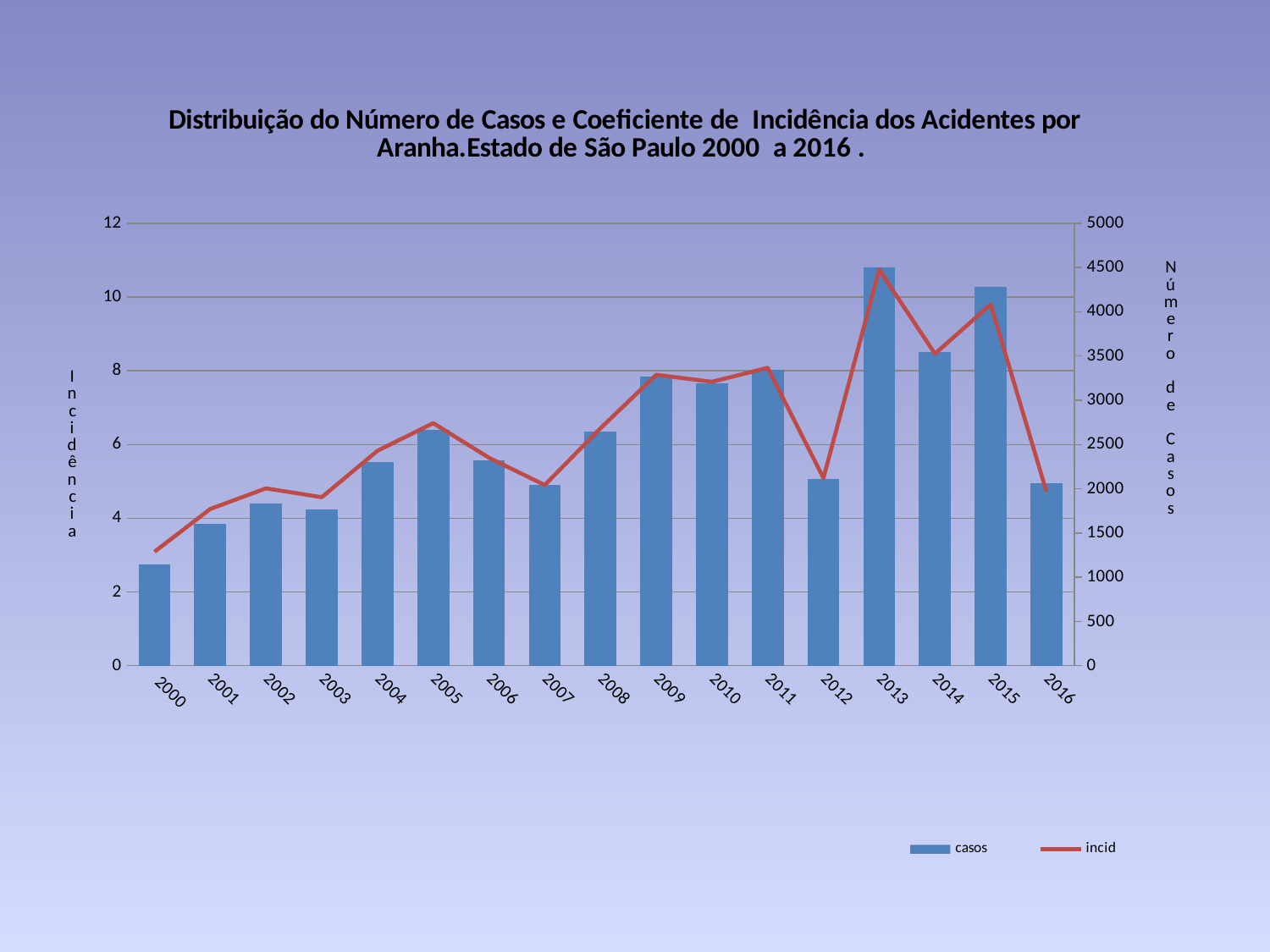
Is the number of cases (casos) for 2013 greater or less than 4000? greater Is the incidence (incid) value for 2013 greater or less than 10? greater Which year has the lowest number of cases (casos)? 2000 What kind of chart is shown on the slide? A combined bar and line chart How many years are shown on the x axis? 17 How many series does the legend list? 2 Which year has more cases (casos), 2009 or 2012? 2009 Do the number of cases (casos) generally rise or fall from 2000 to 2013? rise Is the incidence (incid) value for 2000 greater or less than 4? less Which series is drawn as a line in the chart? incid Which year has the highest number of cases (casos)? 2013